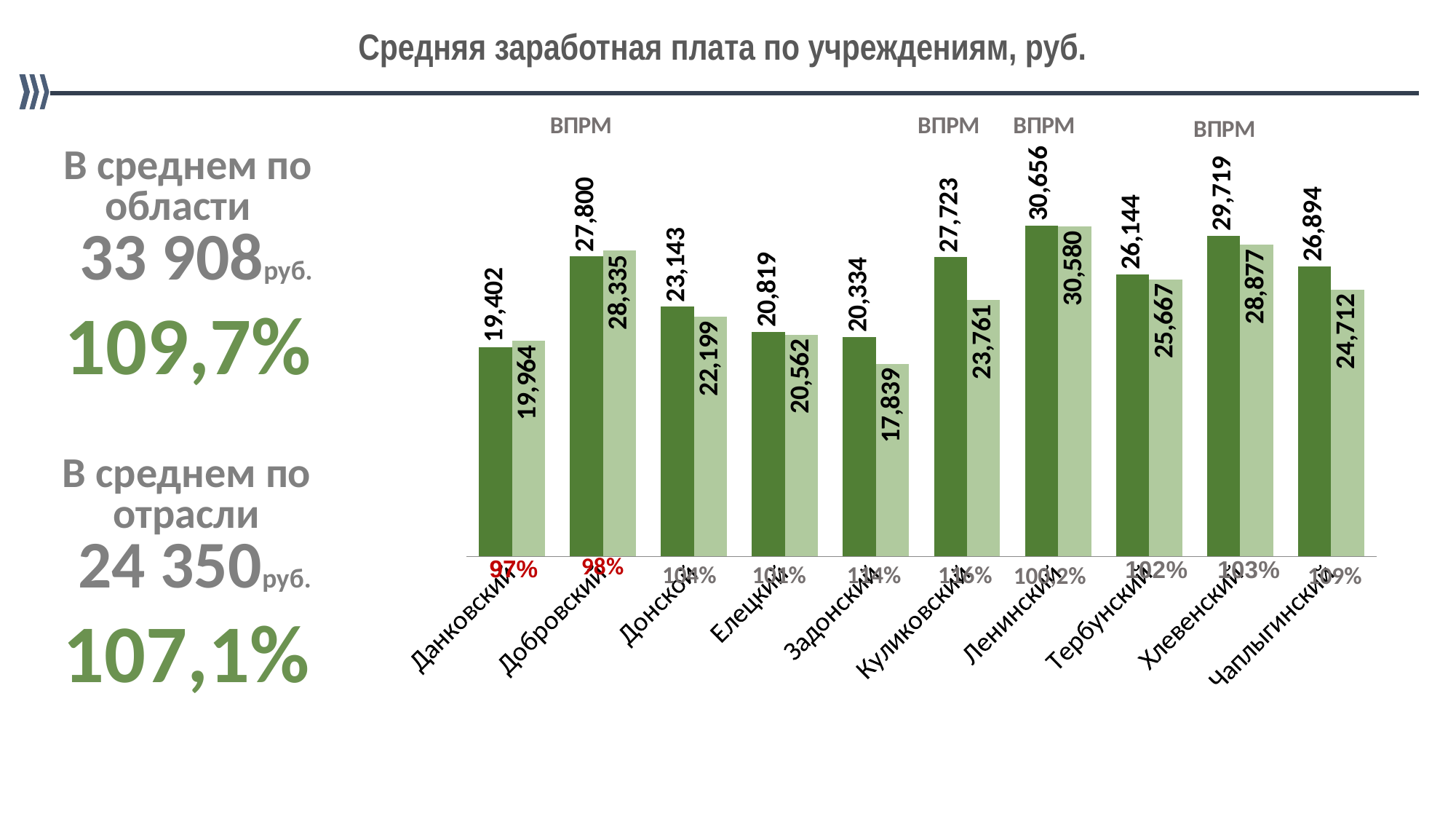
What type of chart is shown on the slide? bar chart What is the value of the dark green bar for Ленинский? 30,656 Which category has the lowest dark green bar? Данковский What is the difference between the dark green and light green bars for Ленинский? 76 For Донской, which bar is larger, the dark green or the light green? dark green What is the difference between the dark green and light green bars for Куликовский? 3,962 For Добровский, which bar is larger, the dark green or the light green? light green How many categories are shown on the x axis of the chart? 10 Which category has the highest dark green bar? Ленинский Which category has the lowest light green bar? Задонский What is the value of the light green bar for Хлевенский? 28,877 What is the value of the light green bar for Задонский? 17,839